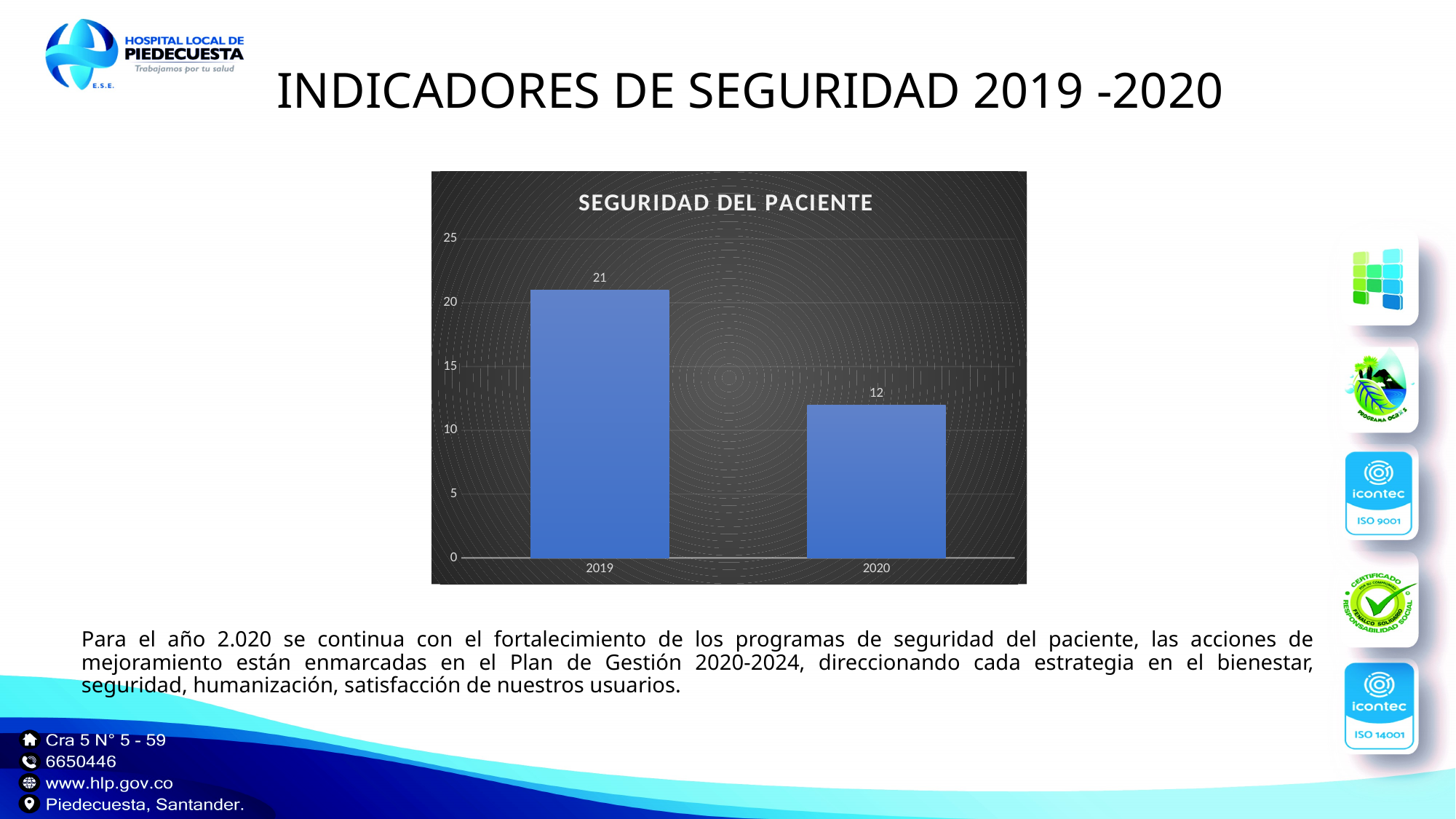
Do the values rise or fall from 2019 to 2020? fall Which year has the lowest value in the chart? 2020 How many categories are shown on the x axis of the chart? 2 Which year has the highest value in the chart? 2019 What is the difference between the values for 2019 and 2020? 9 What kind of chart is shown on the slide? bar chart Is the value for 2019 greater or less than 20? greater What is the value for 2020 in the SEGURIDAD DEL PACIENTE chart? 12 What is the title of the chart? SEGURIDAD DEL PACIENTE Is the value for 2020 greater or less than 15? less What is the value for 2019 in the SEGURIDAD DEL PACIENTE chart? 21 Which is larger, the value for 2019 or the value for 2020? 2019